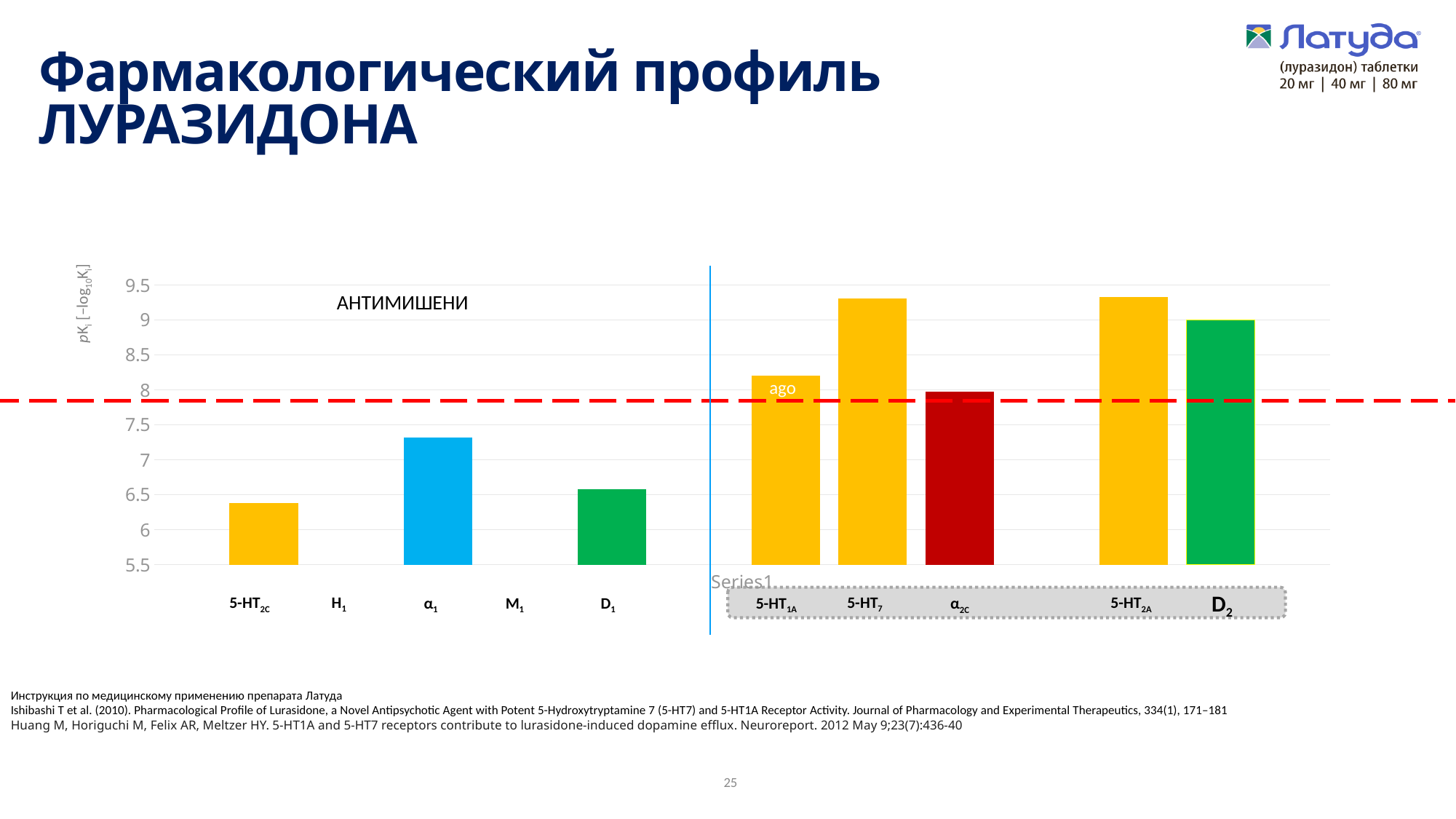
Which has the larger value, 5-HT7 or 5-HT1A? 5-HT7 Which has the larger value, α1 or D1? α1 Is the value for 5-HT1A greater or less than 8? greater Is the value for 5-HT2C greater or less than 6.5? less Is the value for 5-HT7 greater or less than 9? greater Which of the plotted bars has the lowest value? 5-HT2C How many bars are plotted in the chart? 8 What colour is the bar for α2C? red What kind of chart is shown on the slide? bar chart